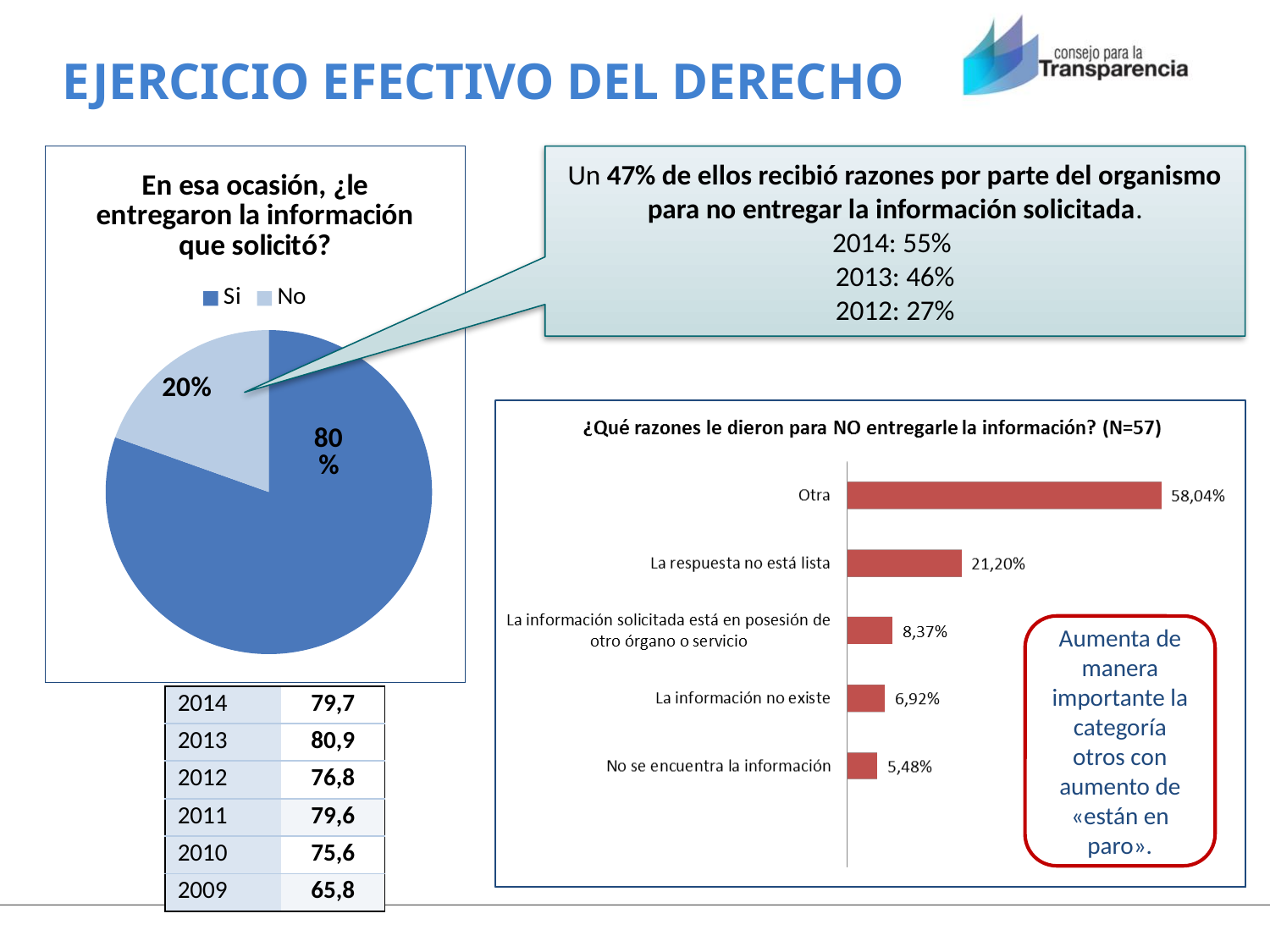
What kind of chart is the chart on the left of the slide? Pie chart In the bar chart '¿Qué razones le dieron para NO entregarle la información?', what is the difference between 'Otra' and 'La respuesta no está lista'? 36,84% In the bar chart '¿Qué razones le dieron para NO entregarle la información?', what is the value for 'La respuesta no está lista'? 21,20% In the pie chart on the left, which slice is larger, 'Si' or 'No'? Si In the pie chart 'En esa ocasión, ¿le entregaron la información que solicitó?', what share is labelled for 'No'? 20% How many entries does the legend of the pie chart on the left list? 2 In the bar chart '¿Qué razones le dieron para NO entregarle la información?', which category has the highest value? Otra In the bar chart '¿Qué razones le dieron para NO entregarle la información?', how many categories are shown? 5 In the bar chart '¿Qué razones le dieron para NO entregarle la información?', what is the value for 'La información no existe'? 6,92% In the bar chart '¿Qué razones le dieron para NO entregarle la información?', which category has the lowest value? No se encuentra la información In the bar chart '¿Qué razones le dieron para NO entregarle la información?', what is the value for 'Otra'? 58,04% In the pie chart 'En esa ocasión, ¿le entregaron la información que solicitó?', what share is labelled for 'Si'? 80%